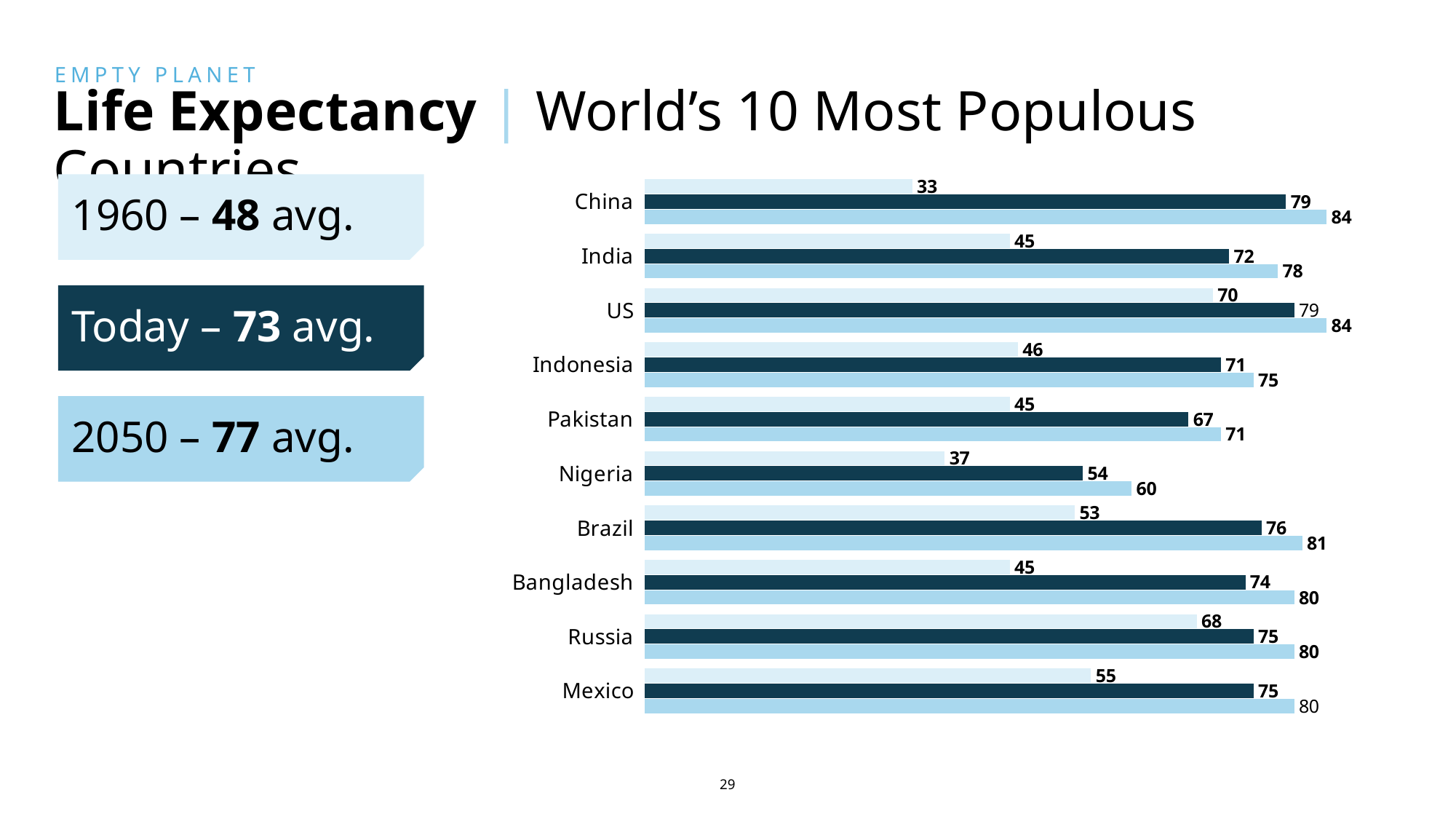
What is the 1960 life expectancy value for China? 33 Which is larger, the Today value for Brazil or the Today value for Russia? Brazil Which country has the lowest Today life expectancy value? Nigeria What is the 2050 life expectancy value for Nigeria? 60 What is the Today life expectancy value for Pakistan? 67 What is the difference between the 2050 and 1960 values for China? 51 What is the difference between the Today values for Bangladesh and Nigeria? 20 What kind of chart is shown on the slide? bar chart Which country has the highest 1960 life expectancy value? US Do the values for India rise or fall from 1960 to 2050? rise How many countries are shown in the chart? 10 What is the average life expectancy shown for Today in the legend box? 73 avg.